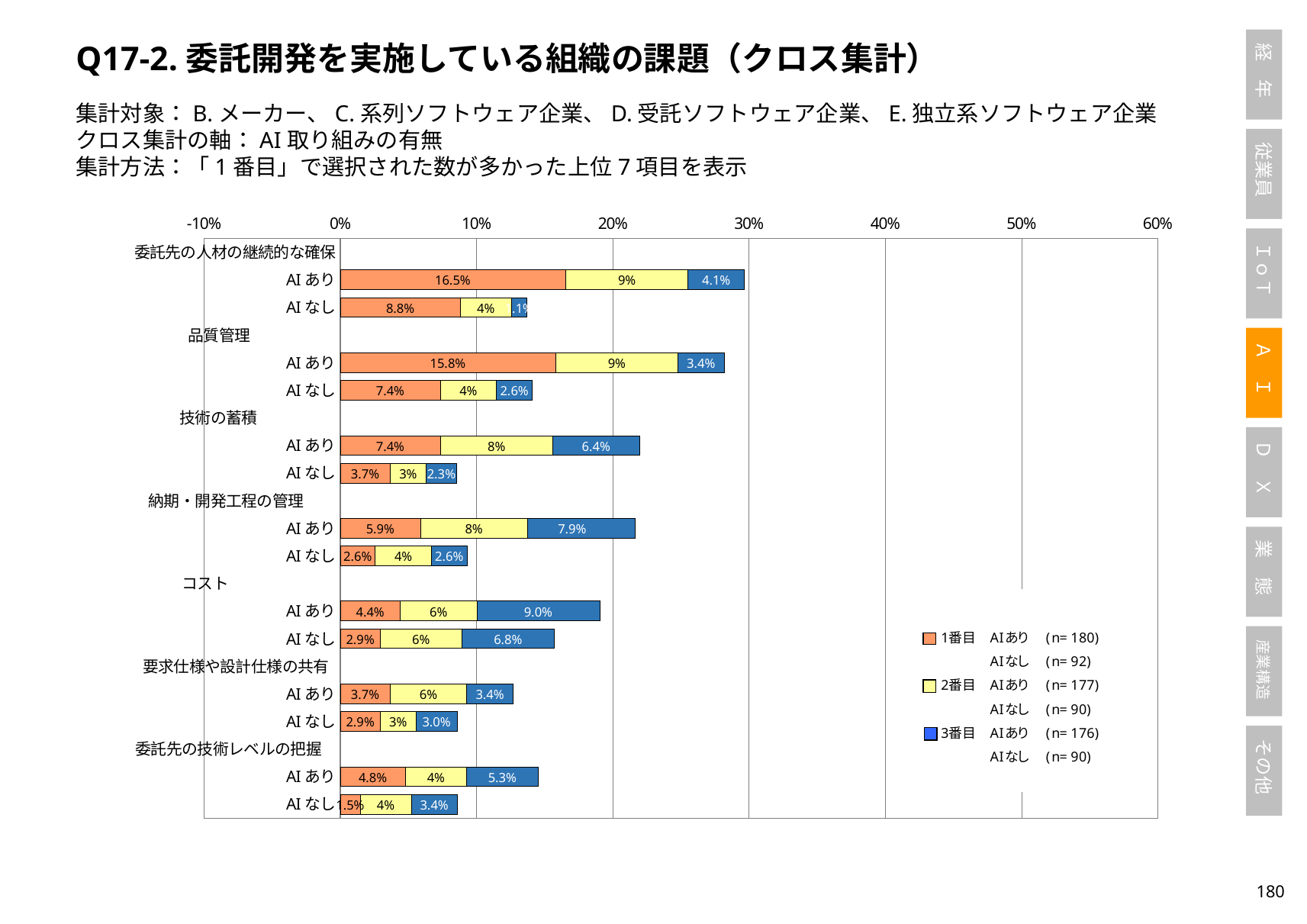
What is the 3番目 value for AIあり under コスト? 9.0% What is the 3番目 value for AIなし under コスト? 6.8% For the 3番目 series under AIあり, which is larger: 納期・開発工程の管理 or 技術の蓄積? 納期・開発工程の管理 How many challenge categories (excluding the AIあり/AIなし sub-rows) are shown on the chart? 7 Which category has the lowest 1番目 value for AIなし? 委託先の技術レベルの把握 What is the 1番目 value for AIなし under 品質管理? 7.4% What is the difference between the 1番目 values for AIあり and AIなし under 品質管理? 8.4% Which category has the highest 1番目 value for AIあり? 委託先の人材の継続的な確保 What kind of chart is shown on the slide? bar chart Is the total length of the AIあり bar for 委託先の人材の継続的な確保 greater or less than 20%? greater How many series does the chart legend list? 3 What is the 1番目 value for AIあり under 委託先の人材の継続的な確保? 16.5%